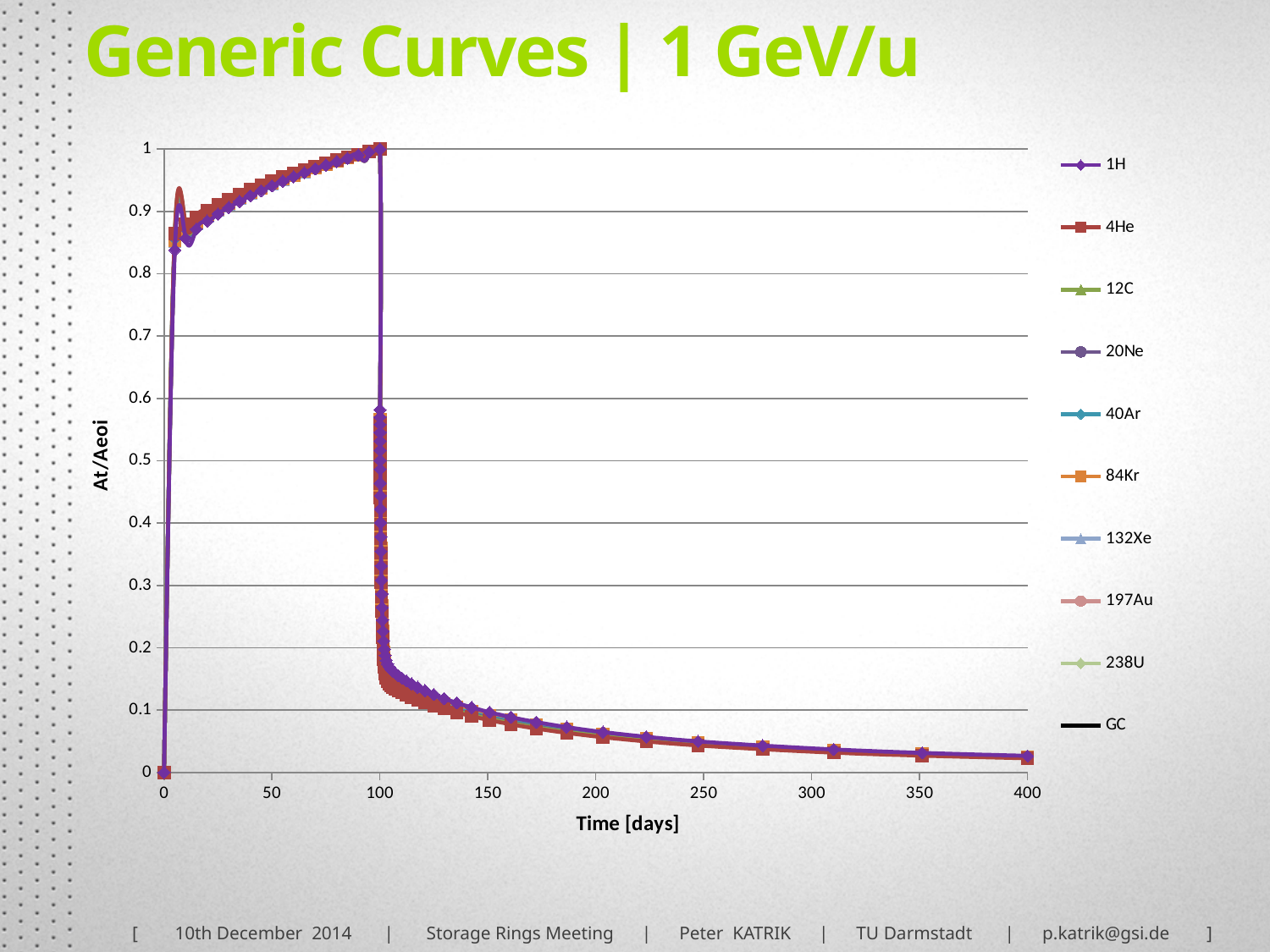
Between 100 and 400 days, do the curves rise or fall? fall What is the title of the x axis? Time [days] At what time in days do the curves reach their peak? 100 Is the value of the curves at 50 days greater or less than 0.5? greater How many series does the legend list? 10 What is the peak value reached by the curves? 1 Is the value of the curves at 200 days greater or less than 0.2? less Is the value of the curves at 400 days greater or less than 0.1? less What is the title of the y axis? At/Aeoi What kind of chart is shown on the slide? line chart Between 20 and 100 days, do the curves rise or fall? rise